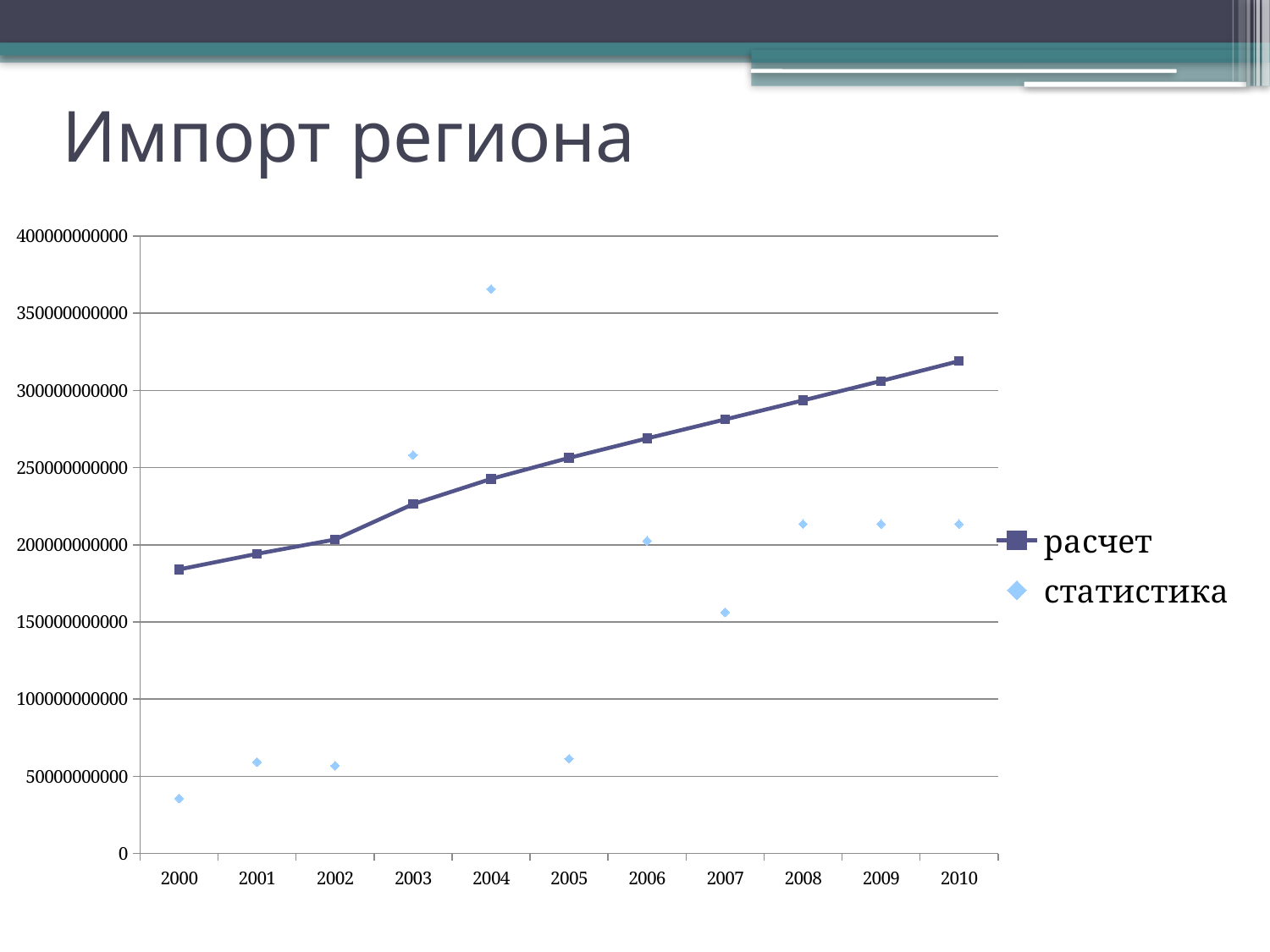
Is the статистика value for 2004 greater or less than 350000000000? greater In which year is the статистика value lowest? 2000 How many years are shown on the x axis? 11 In 2010, which series has the larger value, расчет or статистика? расчет What is the title of the slide containing the chart? Импорт региона Is the расчет value for 2000 greater or less than 200000000000? less Is the расчет value for 2010 greater or less than 300000000000? greater In which year is the статистика value highest? 2004 What kind of chart is shown on the slide? line chart How many series does the legend list? 2 Which series is drawn as a line with square markers? расчет Does the расчет series rise or fall from 2000 to 2010? rises